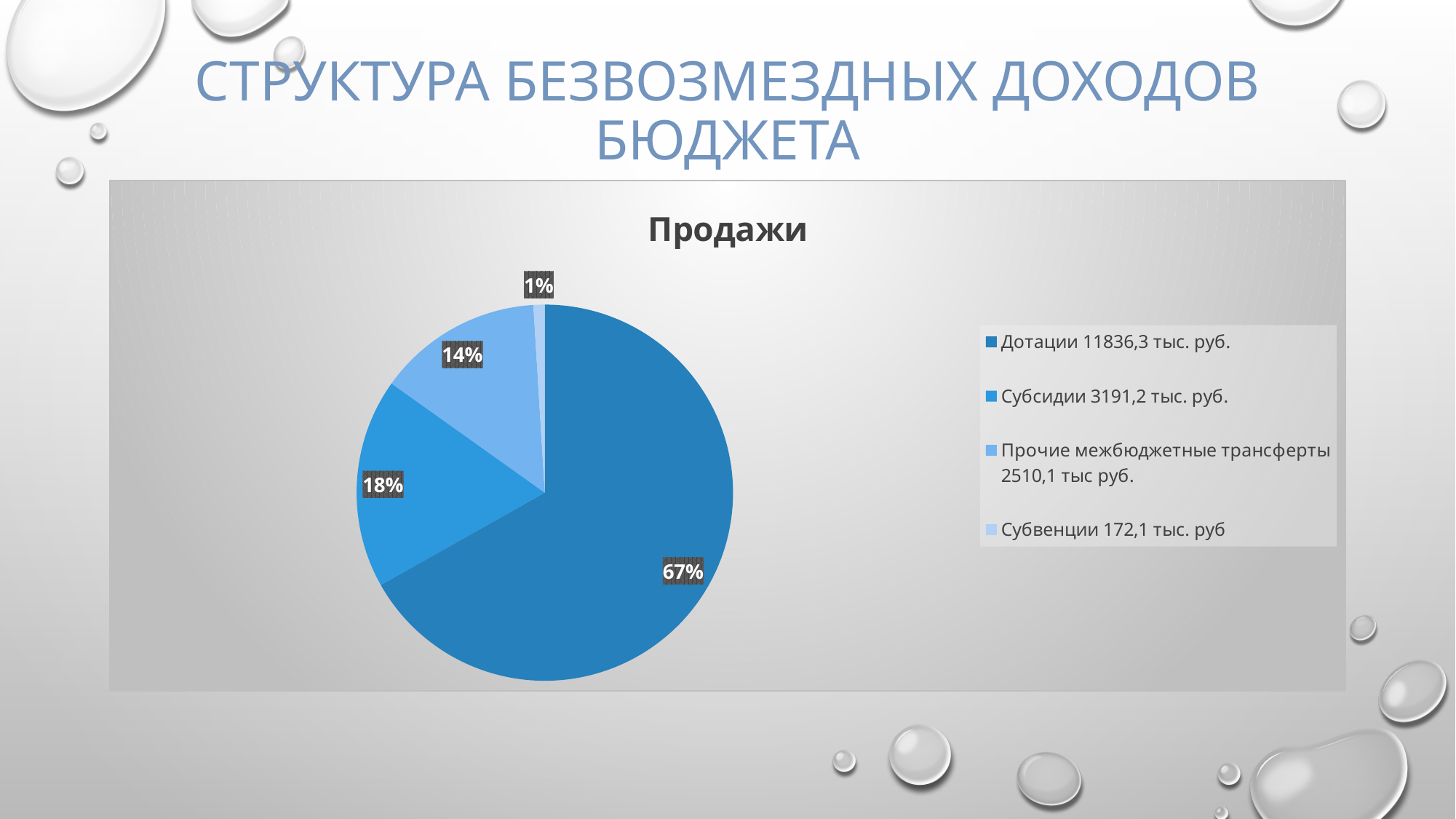
What kind of chart is shown on the slide? pie chart What share of the pie does the Прочие межбюджетные трансферты slice represent? 14% How many slices does the pie chart have? 4 What is the title of the chart? Продажи Which slice is larger, Субсидии or Прочие межбюджетные трансферты? Субсидии What amount is shown in the legend for Субвенции? 172,1 тыс. руб Which category has the largest share of the pie? Дотации What share of the pie does the Субвенции slice represent? 1% What share of the pie does the Дотации slice represent? 67% Which category has the smallest share of the pie? Субвенции What is the difference in percentage points between the Дотации and Субсидии shares? 49